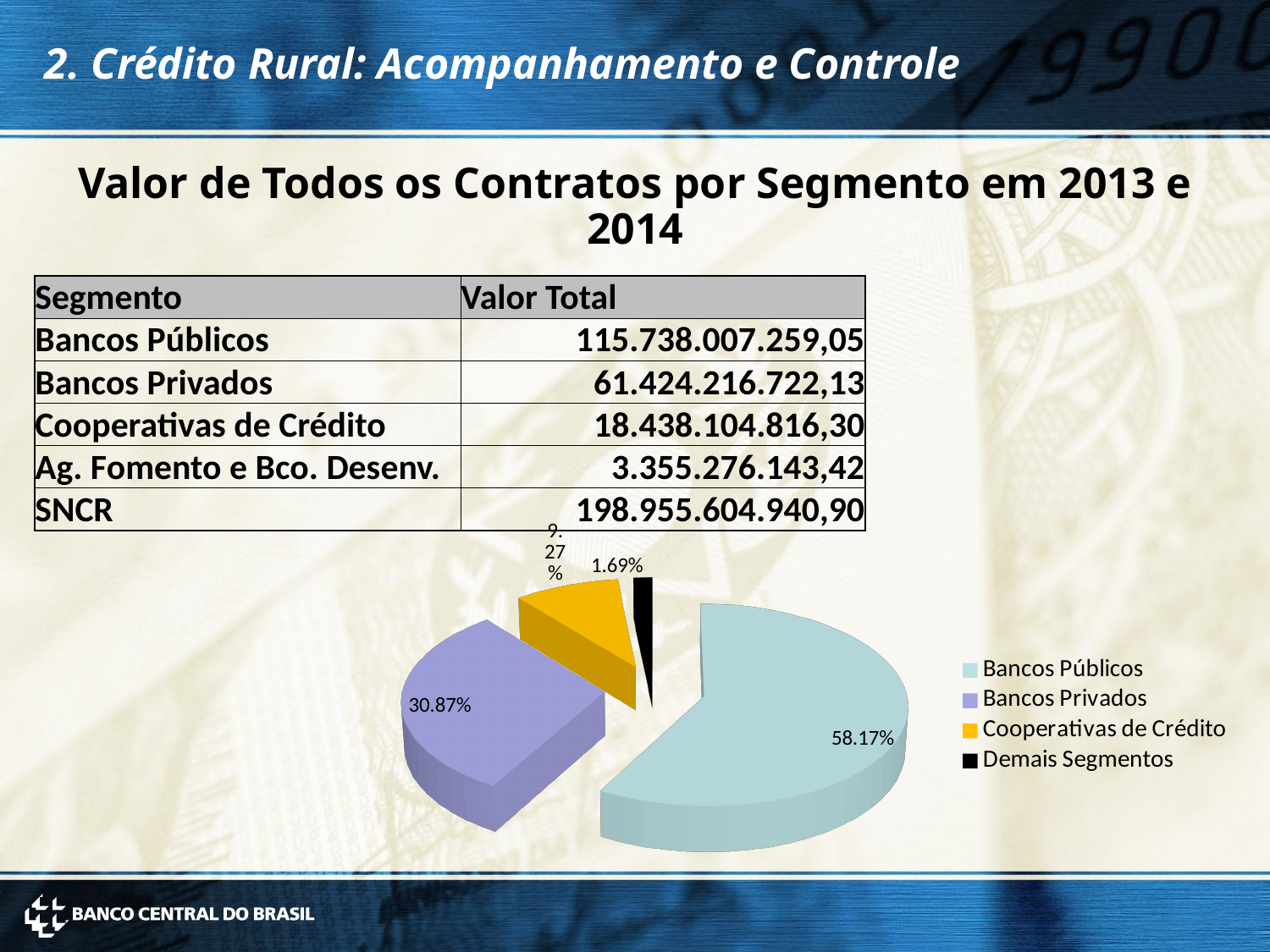
How many entries does the legend of the pie chart list? 4 What share of the pie does Cooperativas de Crédito hold? 9.27% What is the difference in percentage points between the Bancos Públicos slice and the Bancos Privados slice? 27.30% What share of the pie does Demais Segmentos hold? 1.69% What colour is the Demais Segmentos slice in the pie chart? black What share of the pie does Bancos Públicos hold? 58.17% Which slice is larger, Bancos Privados or Cooperativas de Crédito? Bancos Privados Which segment has the smallest slice of the pie? Demais Segmentos Which segment has the largest slice of the pie? Bancos Públicos What share of the pie does Bancos Privados hold? 30.87% What kind of chart is shown on the slide? pie chart How many slices does the pie chart have? 4